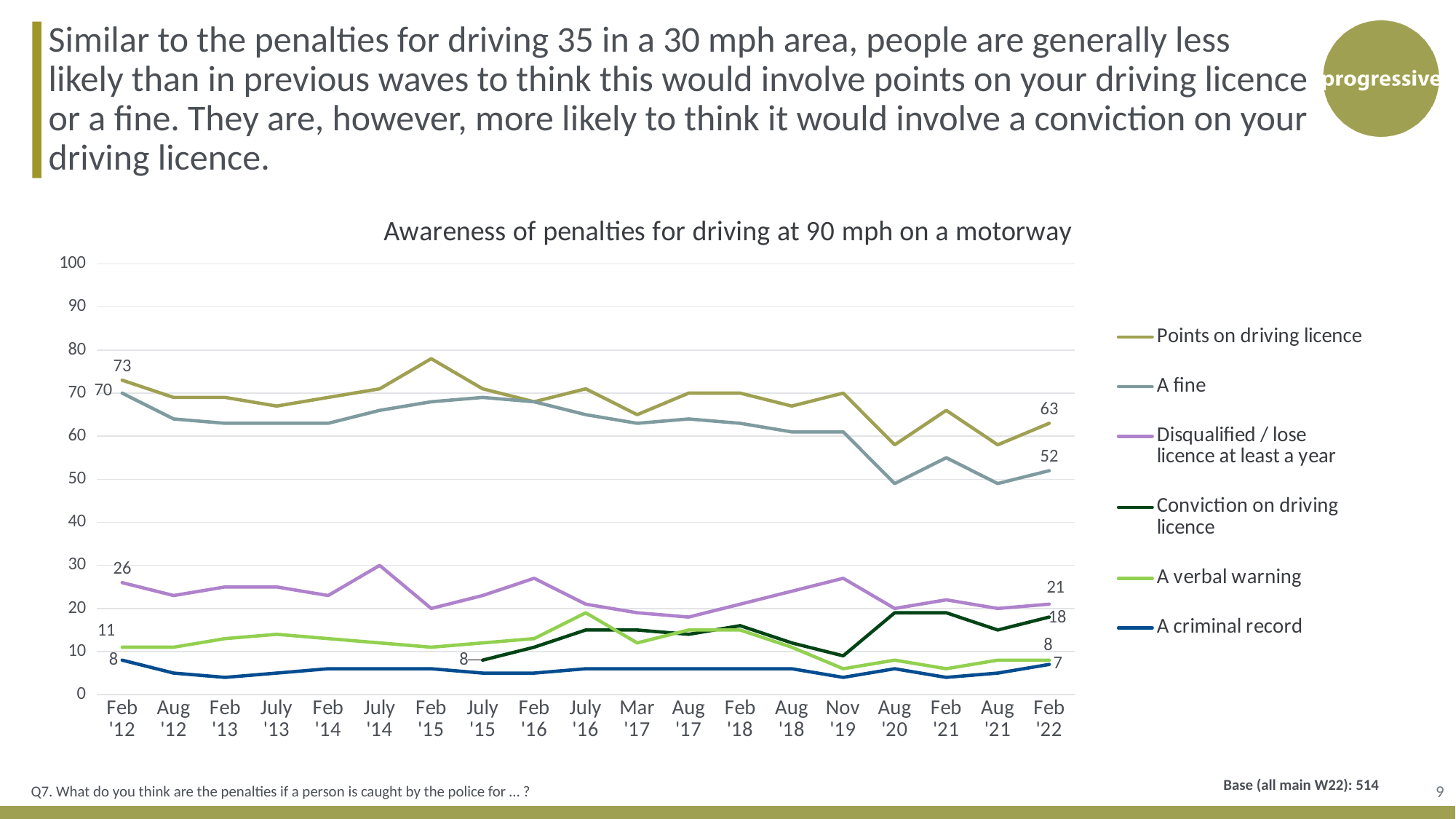
In Feb '22, which is larger: Conviction on driving licence or A verbal warning? Conviction on driving licence Which series has the lowest value in Feb '12? A criminal record What is the value for Points on driving licence in Feb '12? 73 What kind of chart is shown on the slide? Line chart How many series does the legend list? 6 What is the value for A fine in Feb '22? 52 By how much did Points on driving licence fall between Feb '12 and Feb '22? 10 What is the value for Conviction on driving licence in July '15? 8 What is the title of the chart? Awareness of penalties for driving at 90 mph on a motorway Which series has the highest value in Feb '22? Points on driving licence How many survey waves are shown along the x axis? 19 Is the value for Points on driving licence in Feb '15 greater or less than 70? greater